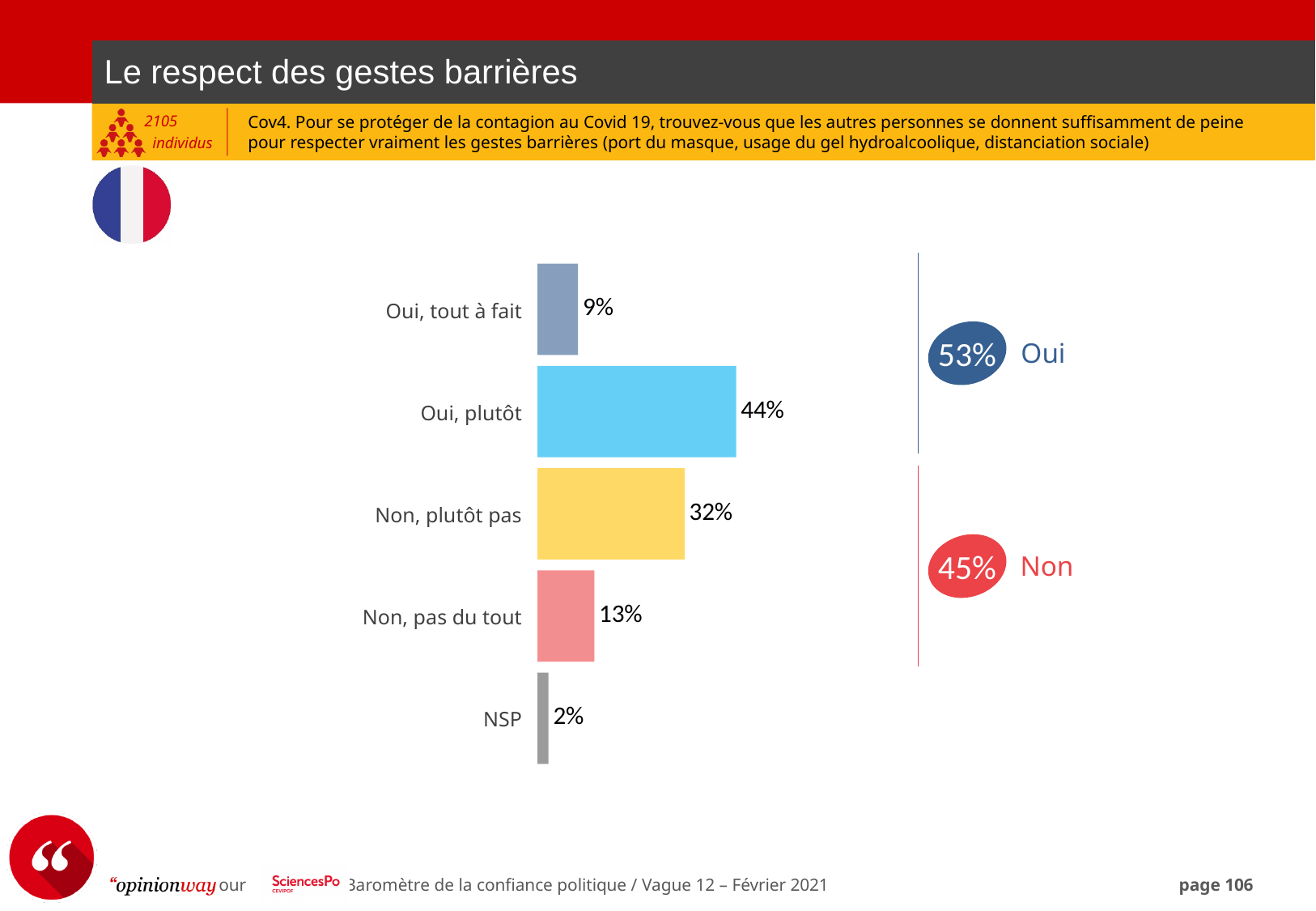
What is the value for "Oui, tout à fait"? 9% Which is larger, "Non, pas du tout" or "Oui, tout à fait"? Non, pas du tout What is the combined total shown for "Oui" responses? 53% What is the value for "Non, pas du tout"? 13% Which category has the lowest value? NSP What is the combined total shown for "Non" responses? 45% How many categories are shown in the chart? 5 What kind of chart is shown on the slide? Bar chart Which category has the highest value? Oui, plutôt What is the value for "NSP"? 2% What is the value for "Oui, plutôt"? 44% What is the difference between "Oui, plutôt" and "Non, plutôt pas"? 12%